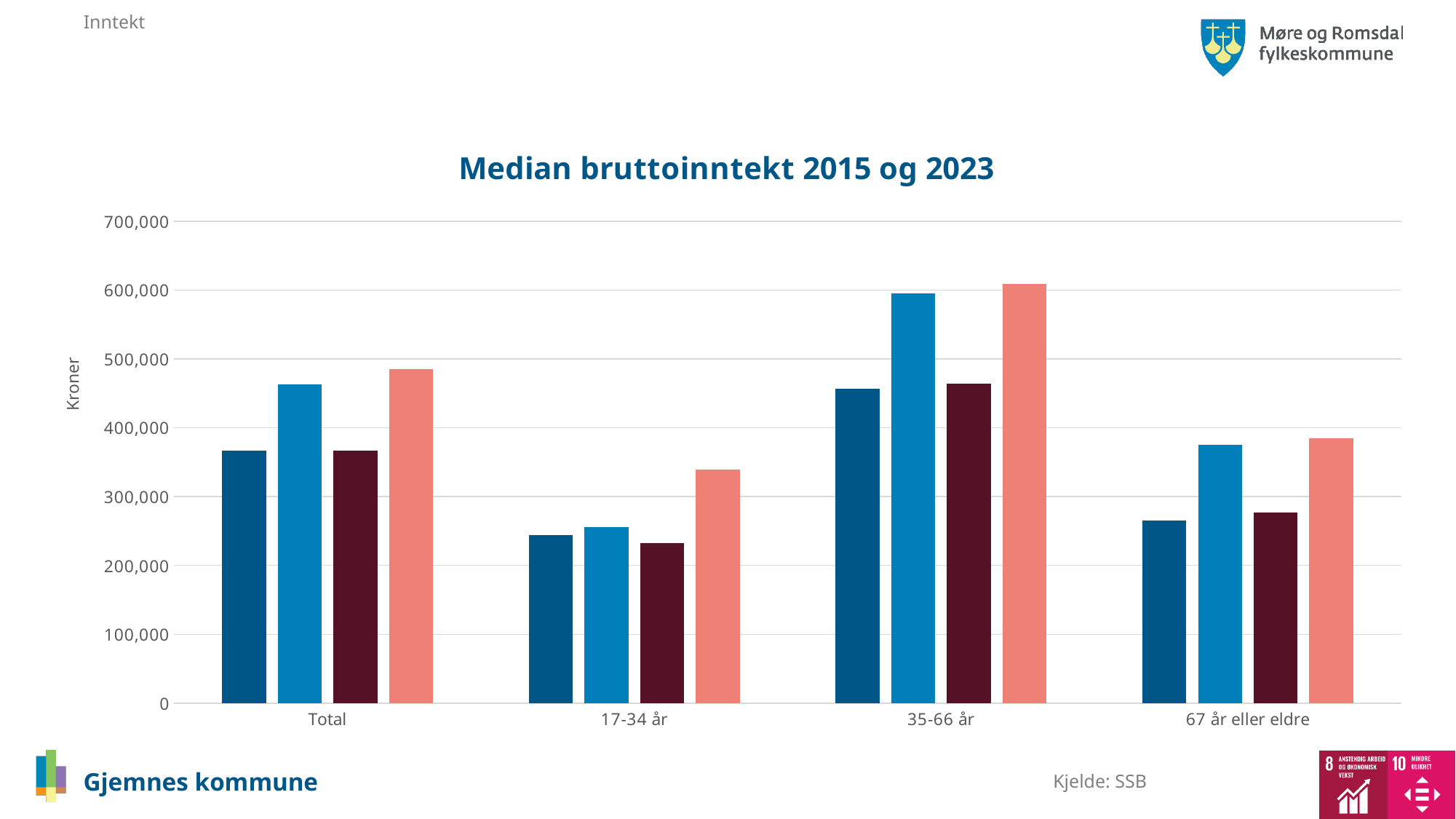
Is the value of the last (salmon) bar for 17-34 år greater or less than 300,000? greater Is the value of the first (dark blue) bar for 35-66 år greater or less than 400,000? greater Which category has the tallest bars in the chart? 35-66 år Is the value of the first (dark blue) bar for Total greater or less than 400,000? less What is the label on the vertical axis of the chart? Kroner Which is larger: the light blue bar for Total or the light blue bar for 67 år eller eldre? Total What is the title of the chart? Median bruttoinntekt 2015 og 2023 How many categories are shown on the x axis of the chart? 4 Which category has the shortest bars in the chart? 17-34 år What kind of chart is shown on the slide? bar chart